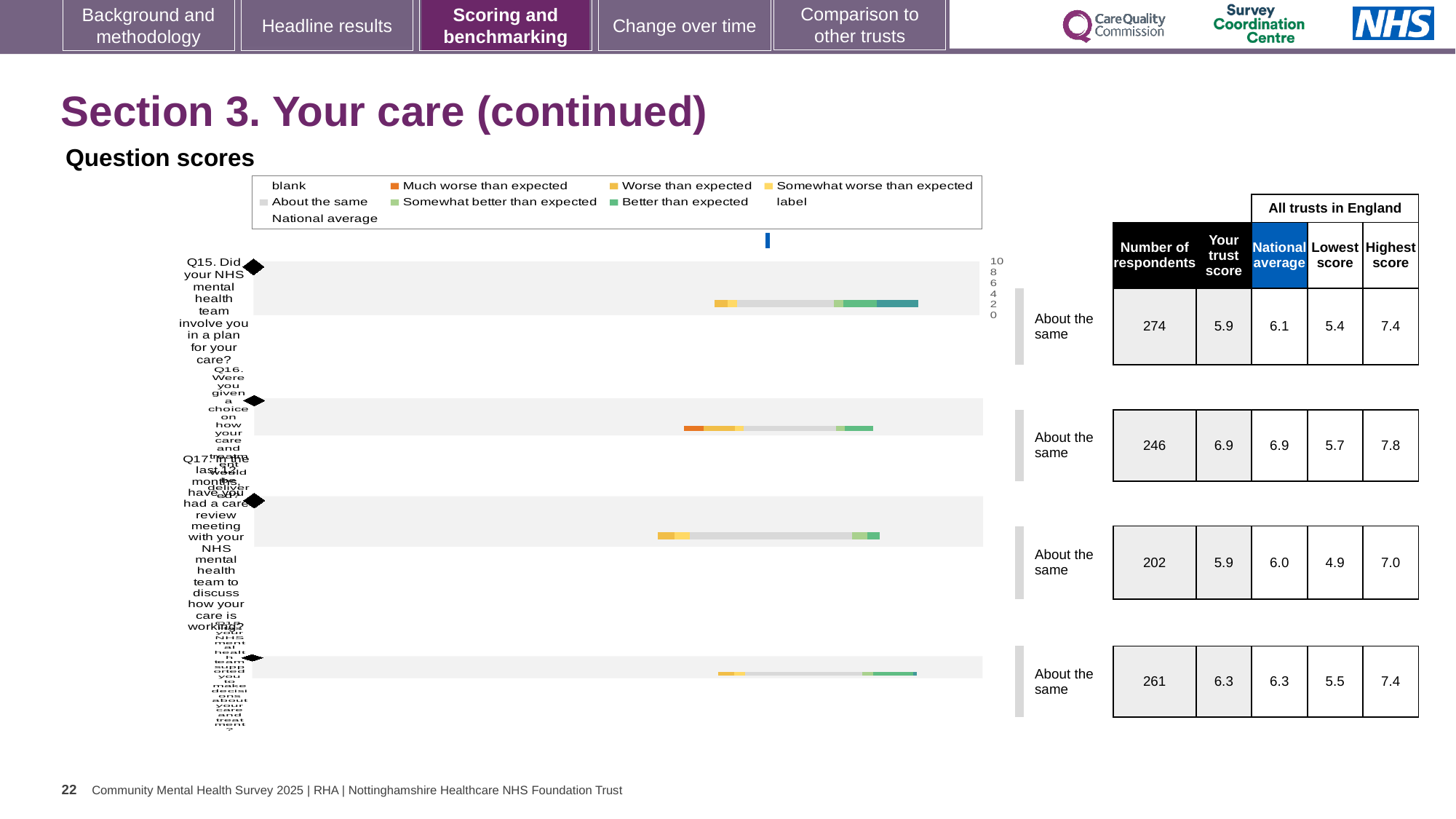
What is the heading printed above the chart? Question scores What colour does the legend use for 'Much worse than expected'? Orange What is the difference between the highest score and the lowest score for Q15 in the table beside the chart? 2.0 Which question has the highest 'Your trust score' in the table beside the chart? Q16 How many question bars are plotted in the question scores chart? 4 Which question has the lowest number of respondents in the table beside the chart? Q17 What is the highest score for Q16 in the table beside the chart? 7.8 What kind of chart is used to show the question scores on this slide? Bar chart For Q17, which is larger in the table beside the chart: the trust score or the national average? National average How many respondents are listed for Q16 in the table beside the chart? 246 What is the 'Your trust score' value for Q15 in the table beside the chart? 5.9 What is the lowest score for Q17 in the table beside the chart? 4.9